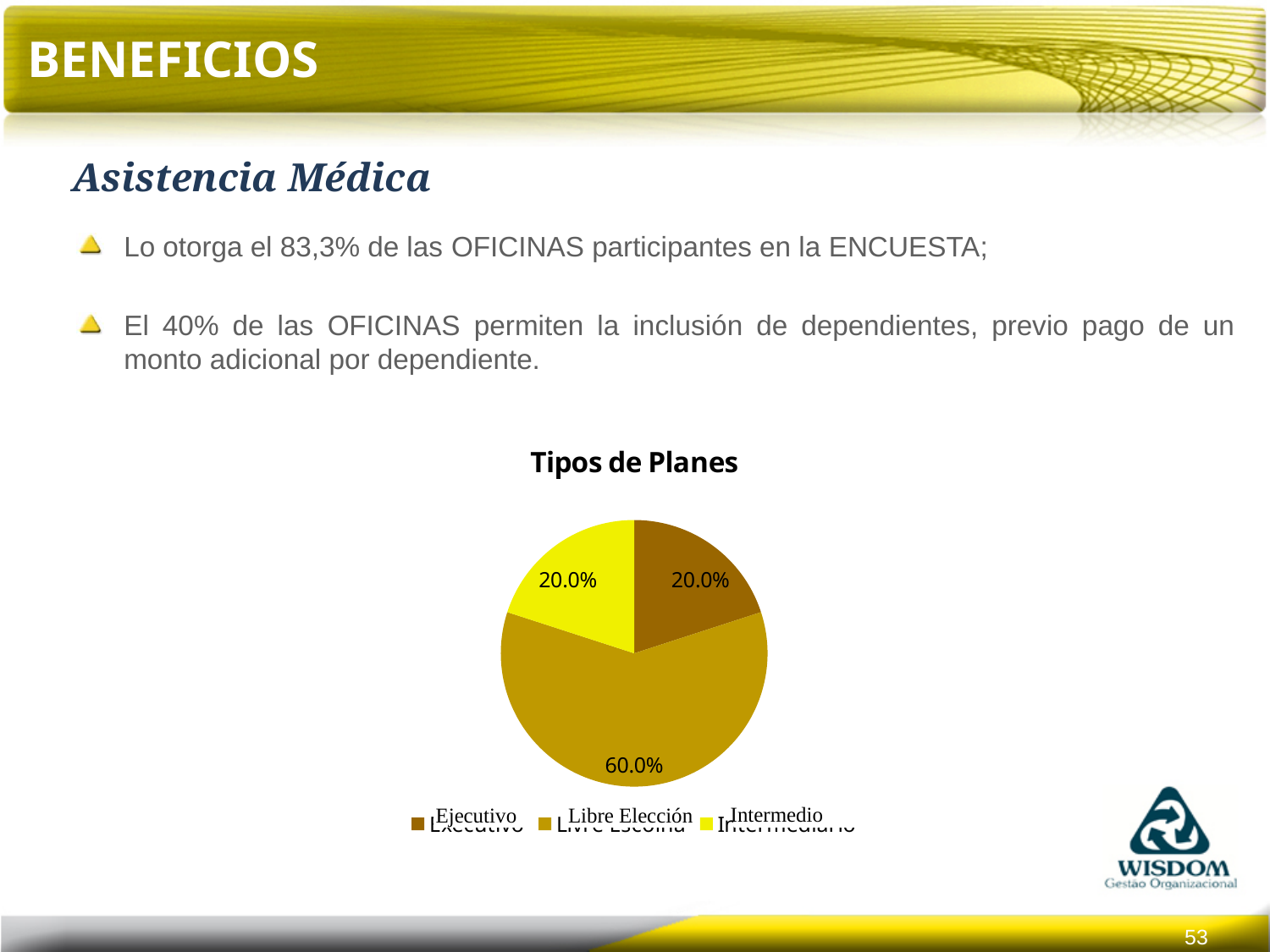
What share of the pie does Libre Elección represent? 60.0% What is the difference in percentage points between Libre Elección and Ejecutivo? 40.0 percentage points Is the share for Libre Elección greater or less than 50%? greater How many slices does the pie chart have? 3 Which plan type has the largest slice of the pie? Libre Elección What share of the pie does Intermedio represent? 20.0% Which is larger, the slice for Libre Elección or the slice for Intermedio? Libre Elección What share of the pie does Ejecutivo represent? 20.0% What kind of chart is shown on the slide? pie chart What is the title of the chart? Tipos de Planes How many entries does the chart legend list? 3 What is the combined share of Ejecutivo and Intermedio? 40.0%